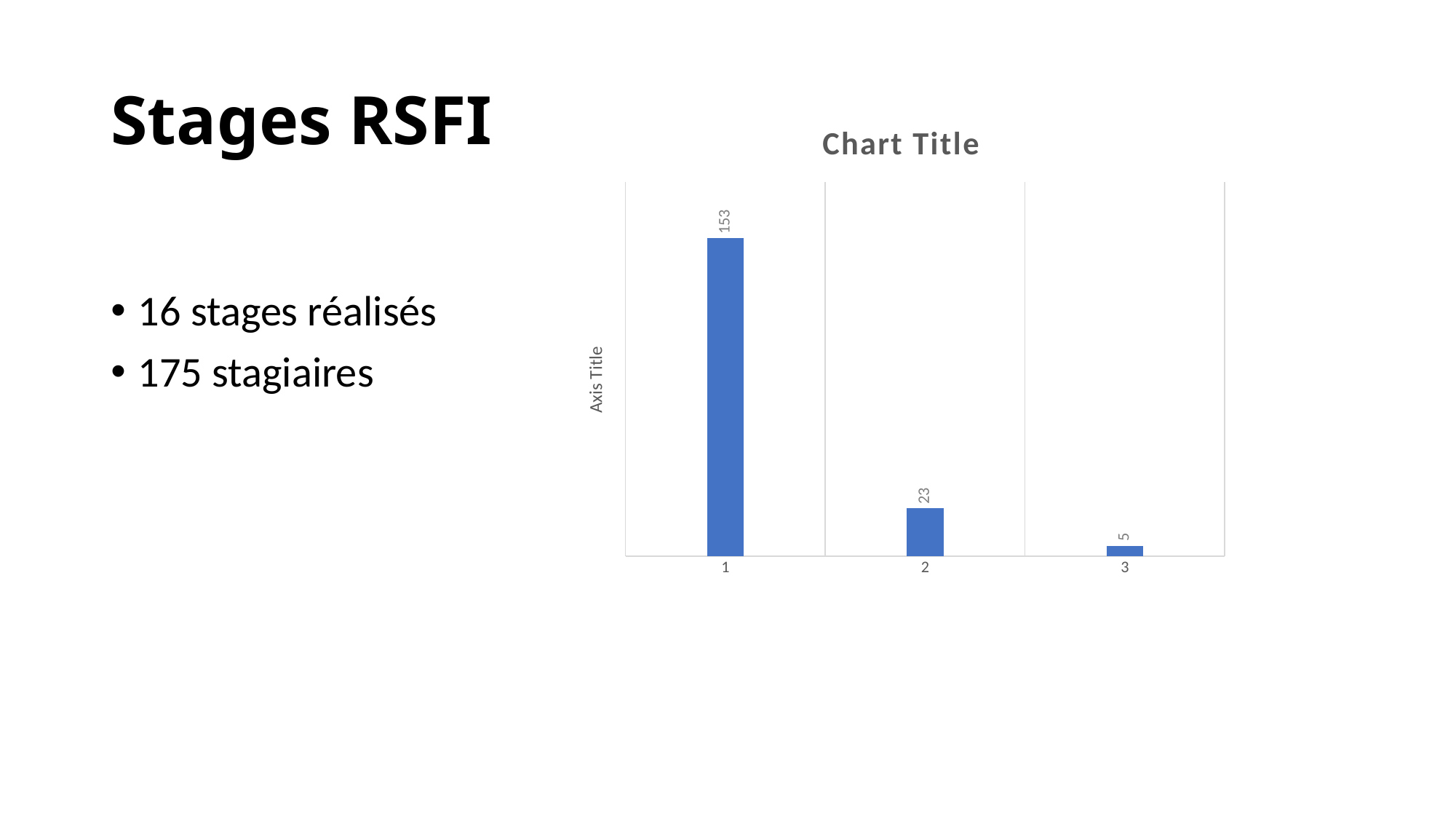
What is the difference between the values for category 1 and category 2? 130 What is the title of the chart? Chart Title What is the value for category 2? 23 What is the value for category 3? 5 What is the value for category 1? 153 Do the values rise or fall from category 1 to category 3? fall How many categories are shown on the x axis? 3 What kind of chart is shown on the slide? bar chart Which category has the highest value? 1 Which is larger, the value for category 2 or the value for category 3? category 2 Which category has the lowest value? 3 What is the difference between the values for category 2 and category 3? 18